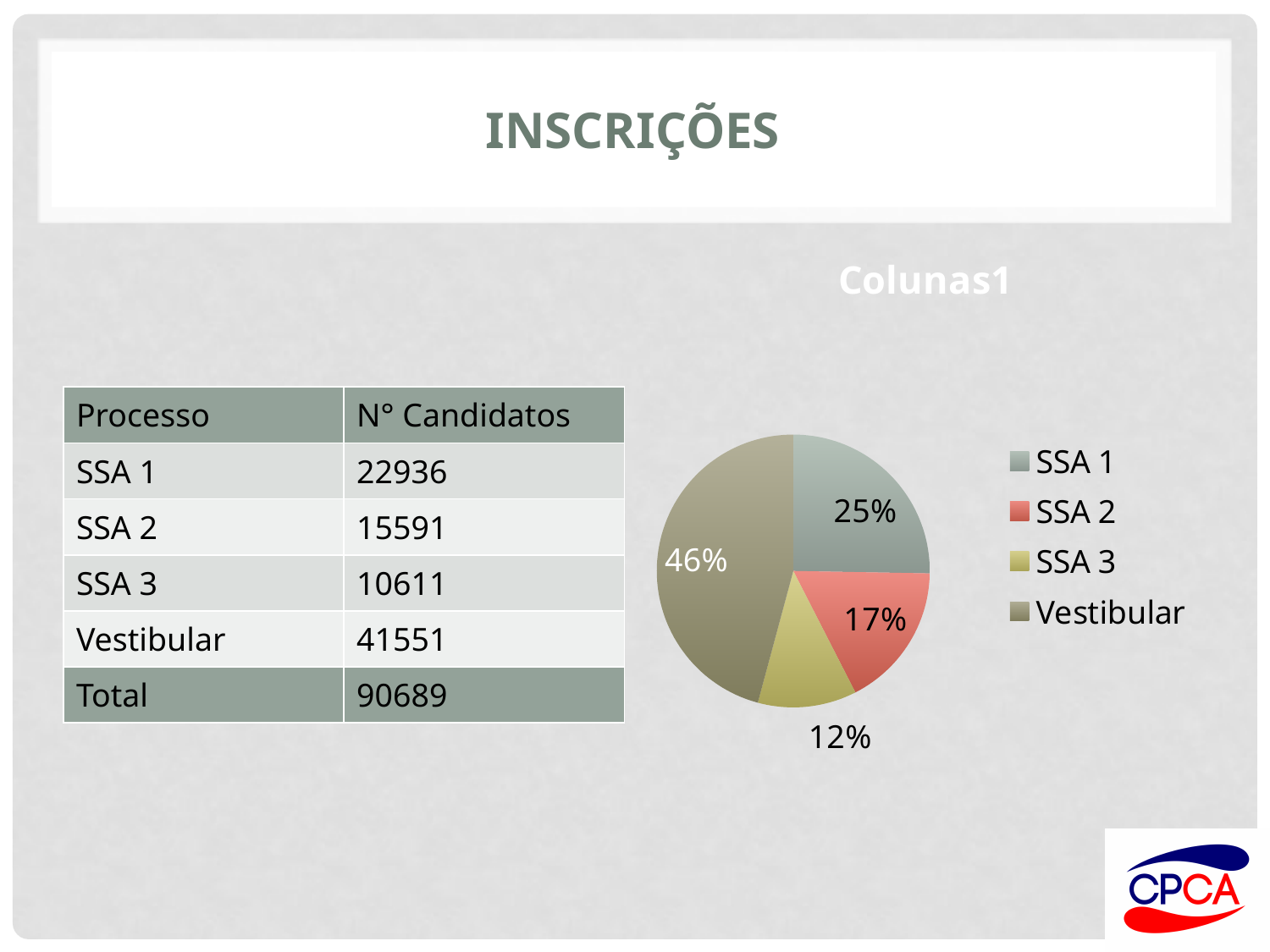
How many slices does the pie chart have? 4 What percentage share does the SSA 2 slice have in the pie chart? 17% What percentage share does the SSA 3 slice have in the pie chart? 12% Which slice is larger in the pie chart, SSA 1 or SSA 2? SSA 1 What is the difference in percentage points between the Vestibular slice and the SSA 1 slice? 21% How many entries does the chart legend list? 4 What kind of chart is shown on the slide? pie chart What percentage share does the Vestibular slice have in the pie chart? 46% Which slice of the pie chart is the largest? Vestibular Which slice of the pie chart is the smallest? SSA 3 What is the title of the chart? Colunas1